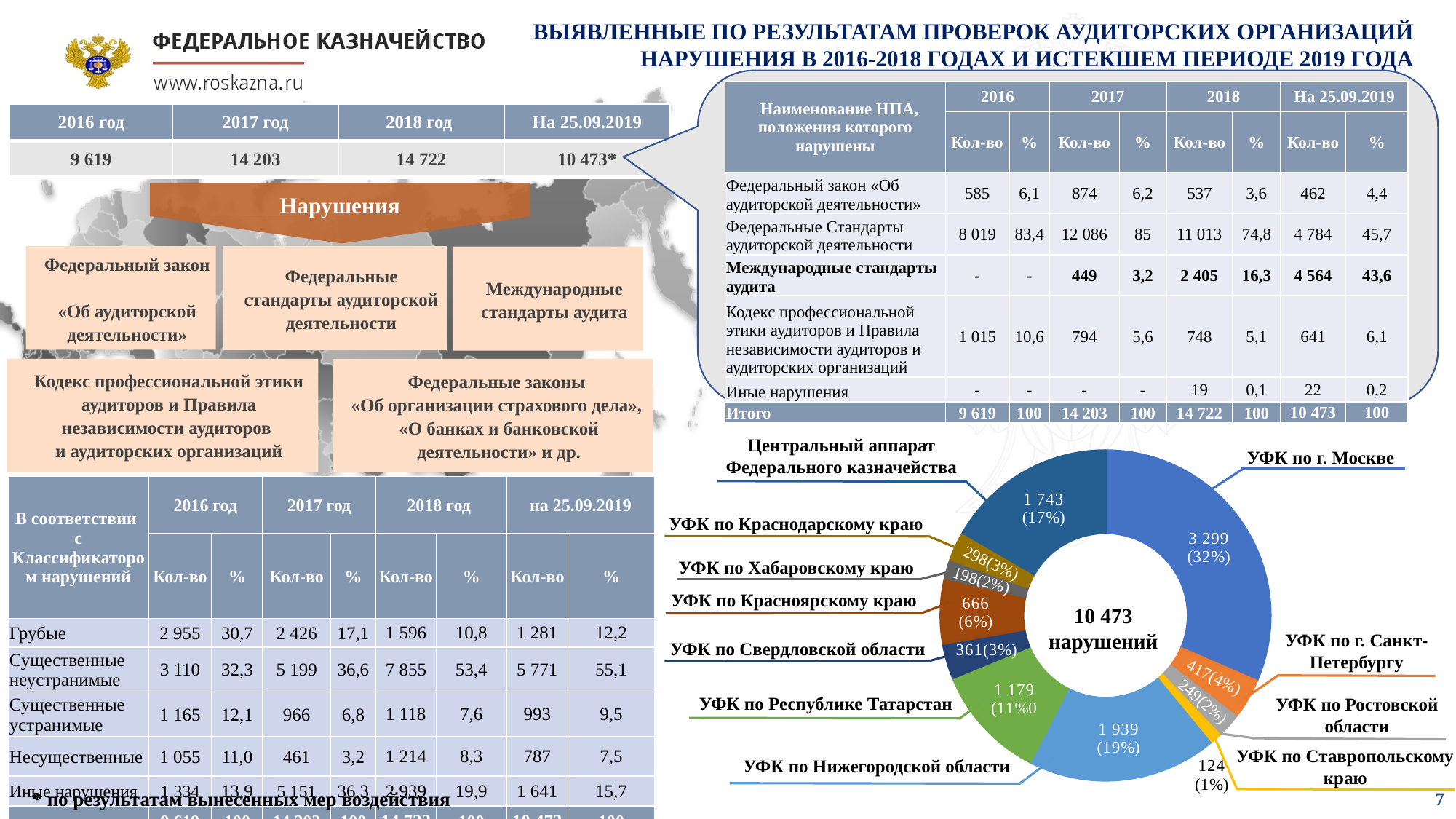
What total number of violations is shown in the centre of the chart? 10 473 нарушений How many violations are shown for УФК по г. Санкт-Петербургу? 417 What is the difference between the number of violations for УФК по г. Москве and УФК по Нижегородской области? 1 360 How many categories (slices) does the chart contain? 11 What kind of chart is shown on the slide? Doughnut (pie) chart How many violations are shown for Центральный аппарат Федерального казначейства? 1 743 Which has more violations in the chart: УФК по Красноярскому краю or УФК по Свердловской области? УФК по Красноярскому краю What share of violations does УФК по Краснодарскому краю account for? 3% What share of violations does УФК по Нижегородской области account for in the chart? 19% Which category has the smallest slice in the chart? УФК по Ставропольскому краю Which category has the largest slice in the chart? УФК по г. Москве How many violations are attributed to УФК по г. Москве in the chart? 3 299